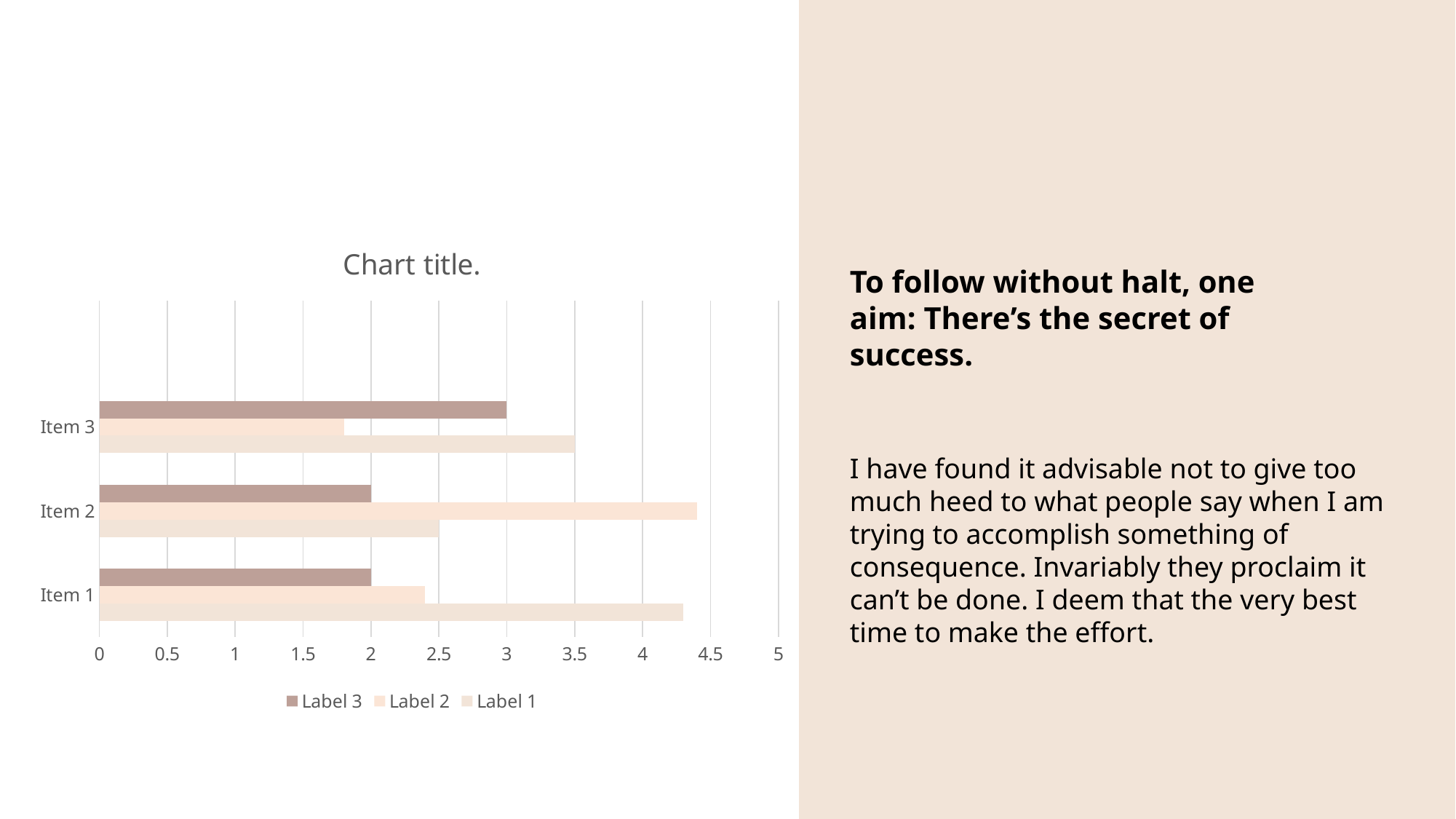
What is the value of Label 3 for Item 3? 3 Which item has the highest value for Label 3? Item 3 What is the title of the chart? Chart title. What is the value of Label 3 for Item 1? 2 What kind of chart is shown on the slide? bar chart How many series does the legend list? 3 What is the value of Label 3 for Item 2? 2 Which series is listed first in the legend? Label 3 What is the difference between the Label 3 values for Item 3 and Item 1? 1 Is the value of Label 2 for Item 2 greater or less than 4? greater How many categories are shown on the vertical axis? 3 Is the value of Label 2 for Item 3 greater or less than 2? less